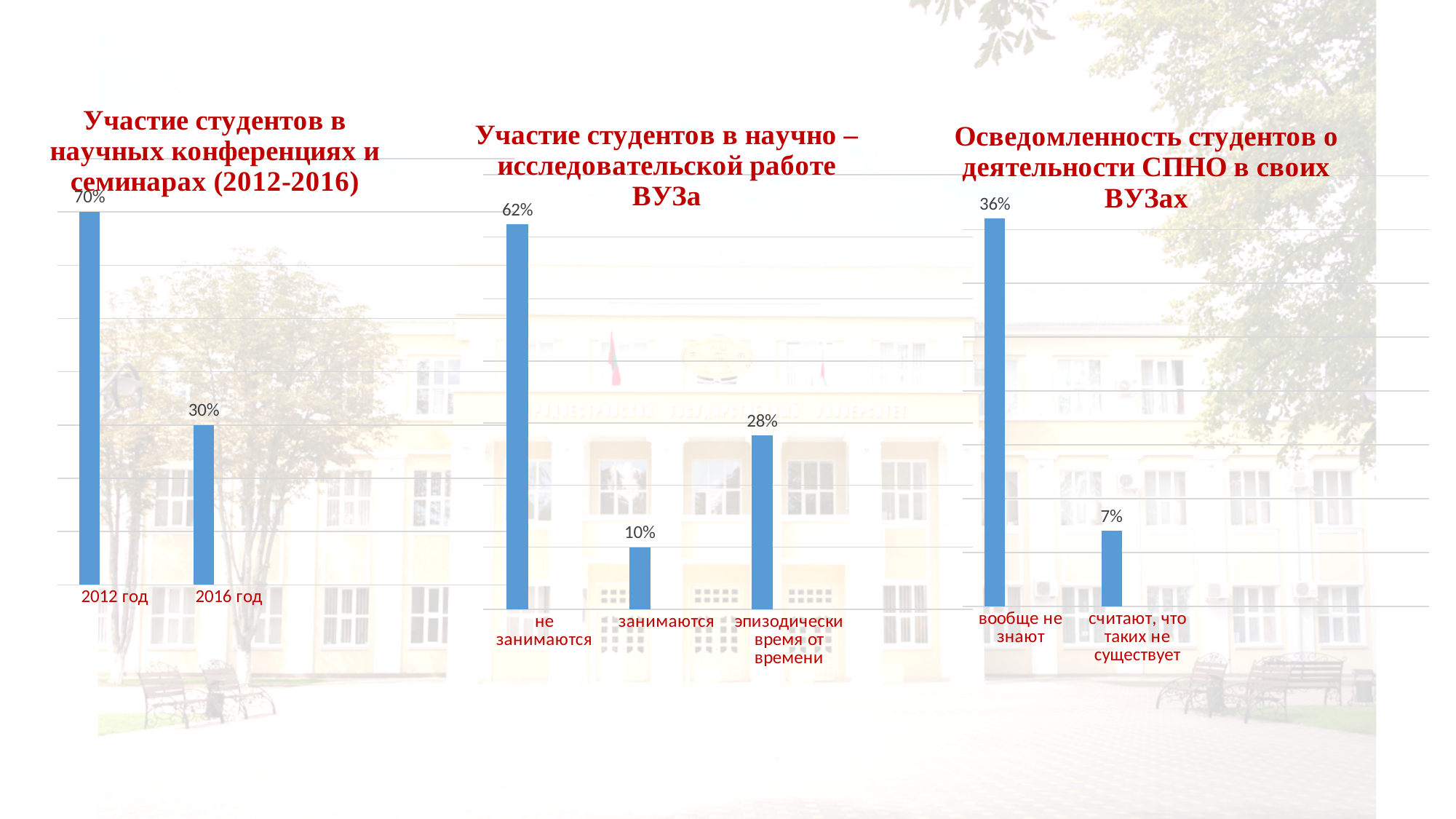
In the left chart (Участие студентов в научных конференциях и семинарах), what is the value for 2016 год? 30% In the left chart (Участие студентов в научных конференциях и семинарах), do the values rise or fall from 2012 год to 2016 год? fall In the middle chart (Участие студентов в научно-исследовательской работе ВУЗа), what is the value for 'эпизодически время от времени'? 28% In the middle chart (Участие студентов в научно-исследовательской работе ВУЗа), which category has the lowest value? занимаются What type of chart is the right chart (Осведомленность студентов о деятельности СПНО в своих ВУЗах)? bar chart In the right chart (Осведомленность студентов о деятельности СПНО в своих ВУЗах), what is the value for 'вообще не знают'? 36% In the right chart (Осведомленность студентов о деятельности СПНО в своих ВУЗах), which is larger: 'вообще не знают' or 'считают, что таких не существует'? вообще не знают In the middle chart (Участие студентов в научно-исследовательской работе ВУЗа), how many categories are shown? 3 In the left chart (Участие студентов в научных конференциях и семинарах), what is the value for 2012 год? 70% In the middle chart (Участие студентов в научно-исследовательской работе ВУЗа), what is the value for 'не занимаются'? 62% In the left chart (Участие студентов в научных конференциях и семинарах), what is the difference between the 2012 год and 2016 год values? 40% In the middle chart (Участие студентов в научно-исследовательской работе ВУЗа), what is the difference between 'не занимаются' and 'занимаются'? 52%